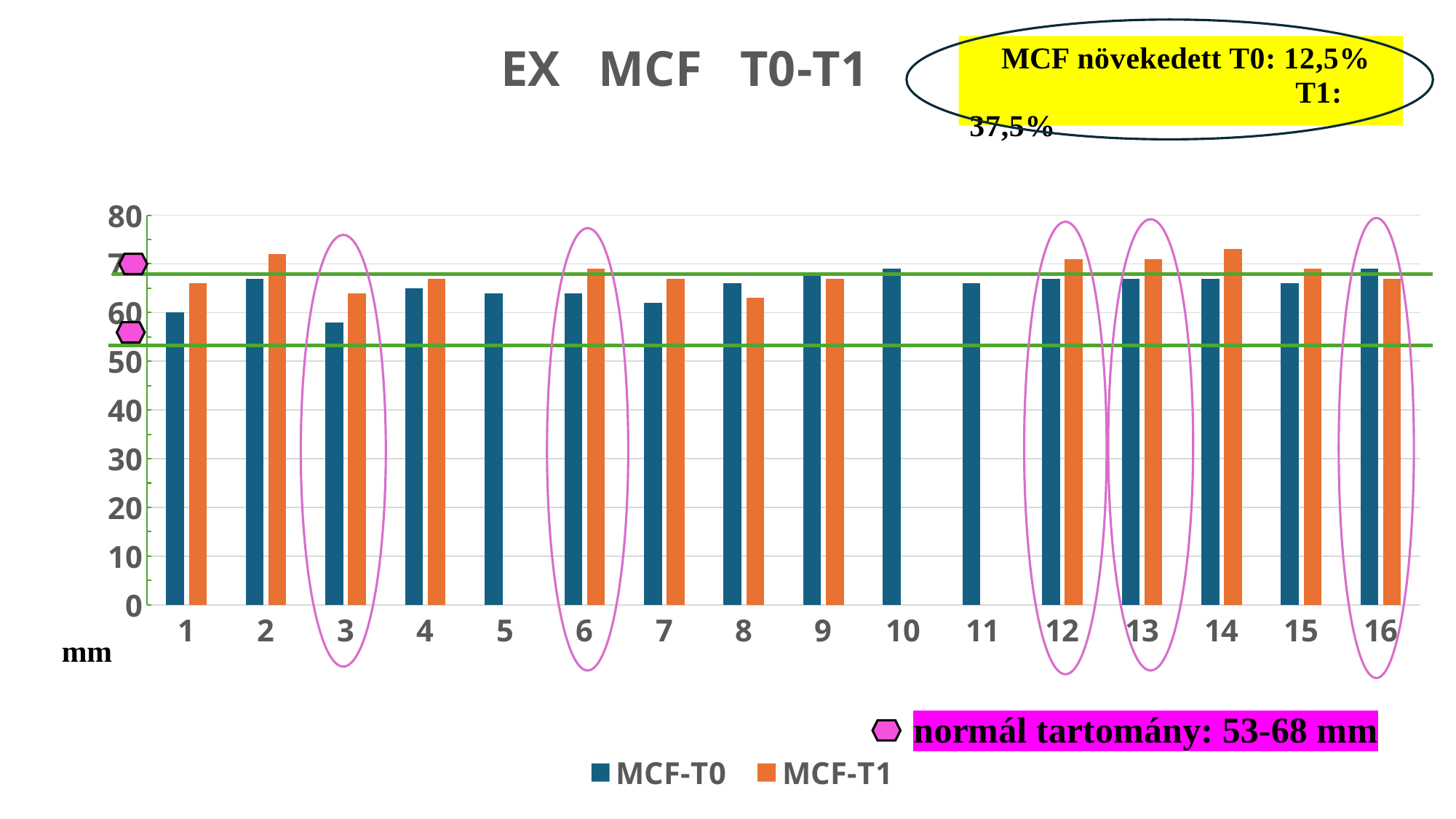
What are the two series named in the legend? MCF-T0 and MCF-T1 For category 8, which is larger: MCF-T0 or MCF-T1? MCF-T0 For category 1, which is larger: MCF-T0 or MCF-T1? MCF-T1 What is the title of the chart? EX MCF T0-T1 How many series does the legend list? 2 Is the MCF-T0 value for category 1 greater or less than 70? less Which category has the lowest MCF-T0 value? 3 How many categories are shown on the x axis? 16 What kind of chart is shown on the slide? bar chart Is the MCF-T0 value for category 3 greater or less than 60? less Is the MCF-T1 value for category 2 greater or less than 70? greater